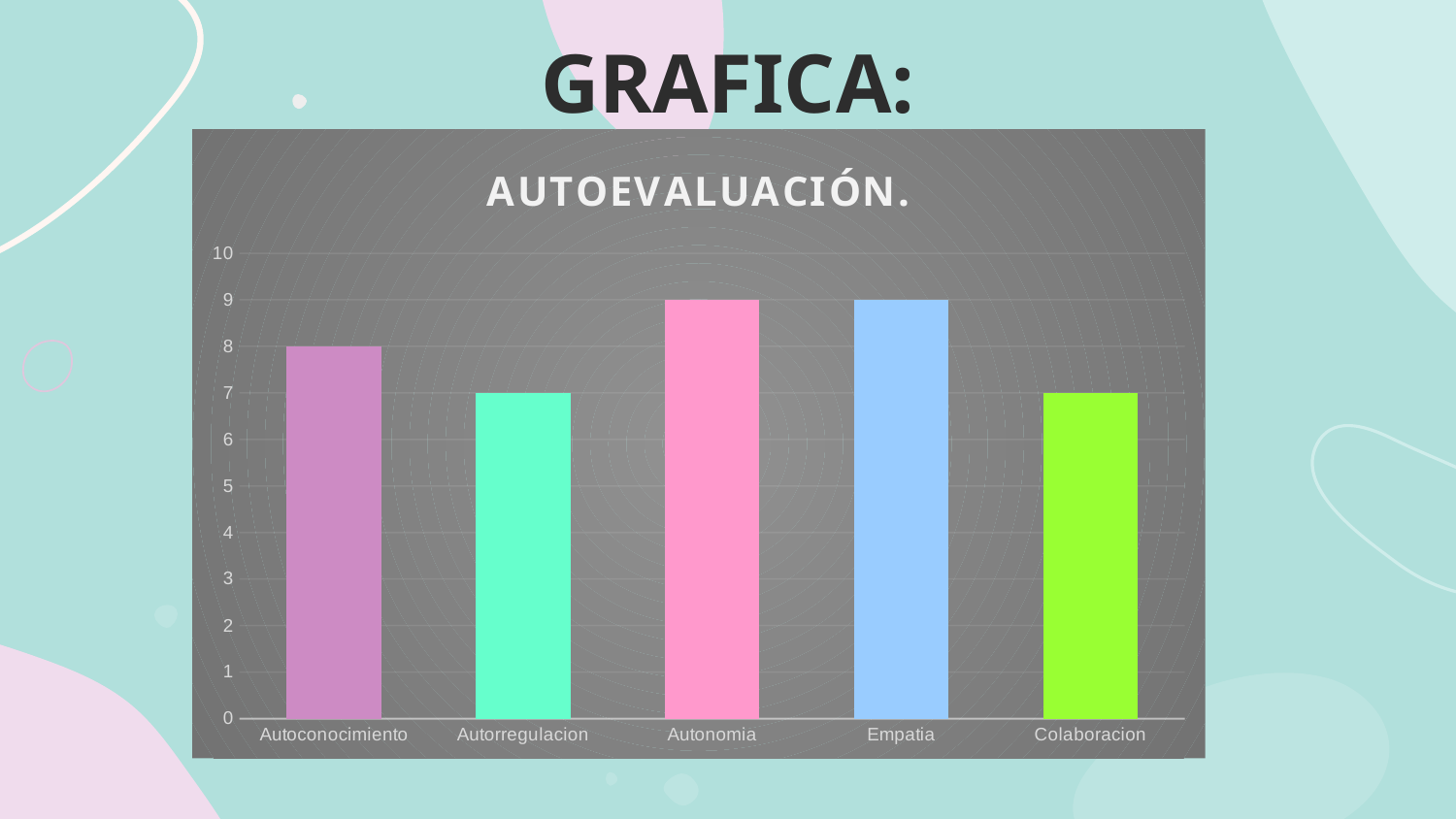
What kind of chart is shown on the slide? Bar chart What is the difference between the values for Autonomia and Autorregulacion? 2 What is the value for Empatia? 9 How many categories are shown on the x axis? 5 What is the title of the chart? AUTOEVALUACIÓN. What is the value for Autonomia? 9 What is the value for Autorregulacion? 7 Which is larger, the value for Autoconocimiento or the value for Colaboracion? Autoconocimiento What is the highest value shown in the chart? 9 What is the value for Autoconocimiento? 8 What is the lowest value shown in the chart? 7 What is the value for Colaboracion? 7